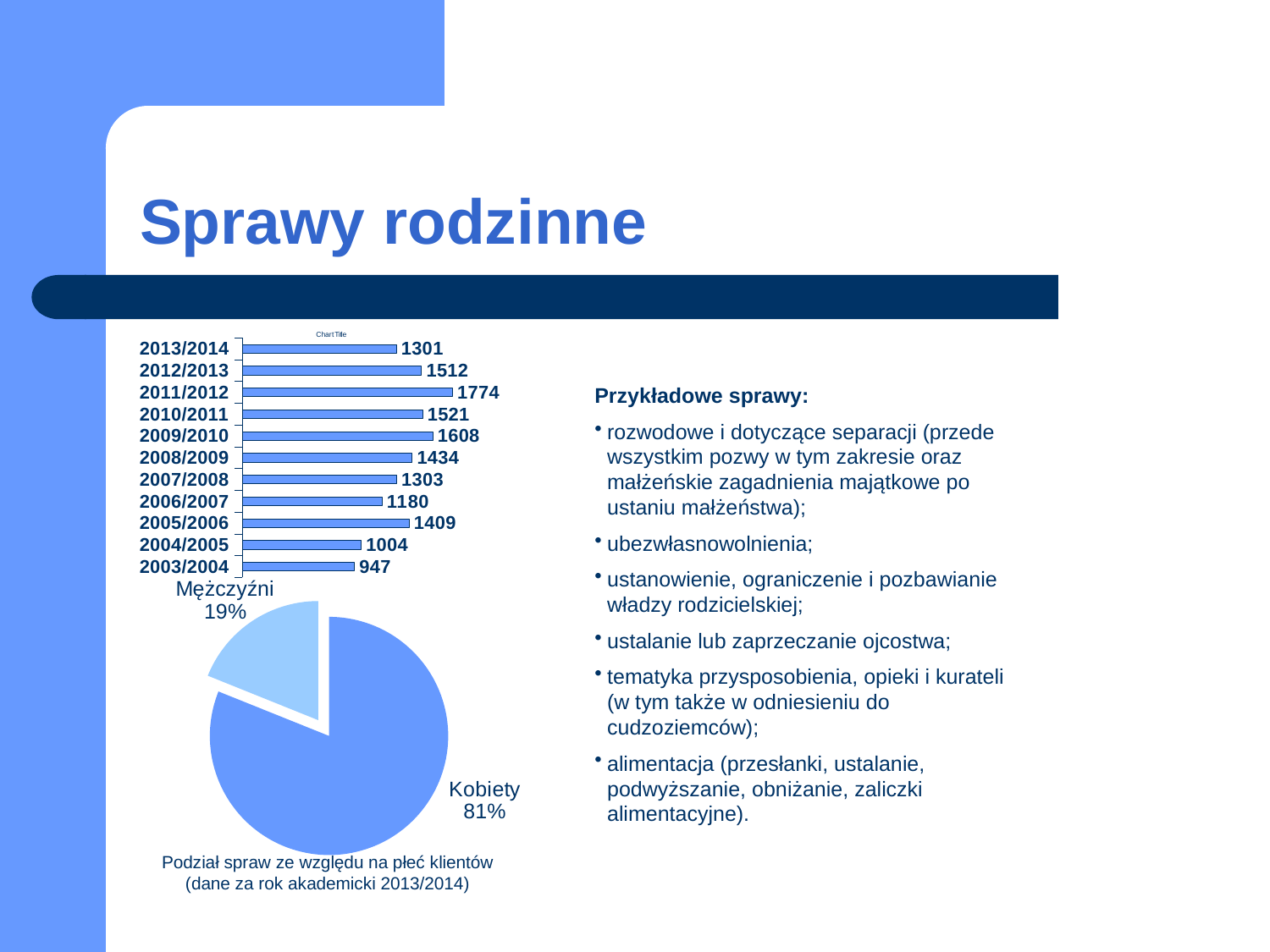
In the bar chart at the top of the slide, which academic year has the lowest value? 2003/2004 In the pie chart at the bottom of the slide, what share is labelled Kobiety? 81% In the bar chart at the top of the slide, what is the difference between the values for 2012/2013 and 2013/2014? 211 In the bar chart at the top of the slide, what is the value for 2003/2004? 947 What kind of chart is the chart at the bottom of the slide? pie chart In the bar chart at the top of the slide, what is the value for 2011/2012? 1774 In the bar chart at the top of the slide, which is larger: the value for 2009/2010 or the value for 2010/2011? 2009/2010 In the pie chart at the bottom of the slide, what share is labelled Mężczyźni? 19% In the bar chart at the top of the slide, what is the value for 2013/2014? 1301 How many academic years are shown in the bar chart at the top of the slide? 11 What kind of chart is the chart at the top of the slide? bar chart In the bar chart at the top of the slide, which academic year has the highest value? 2011/2012